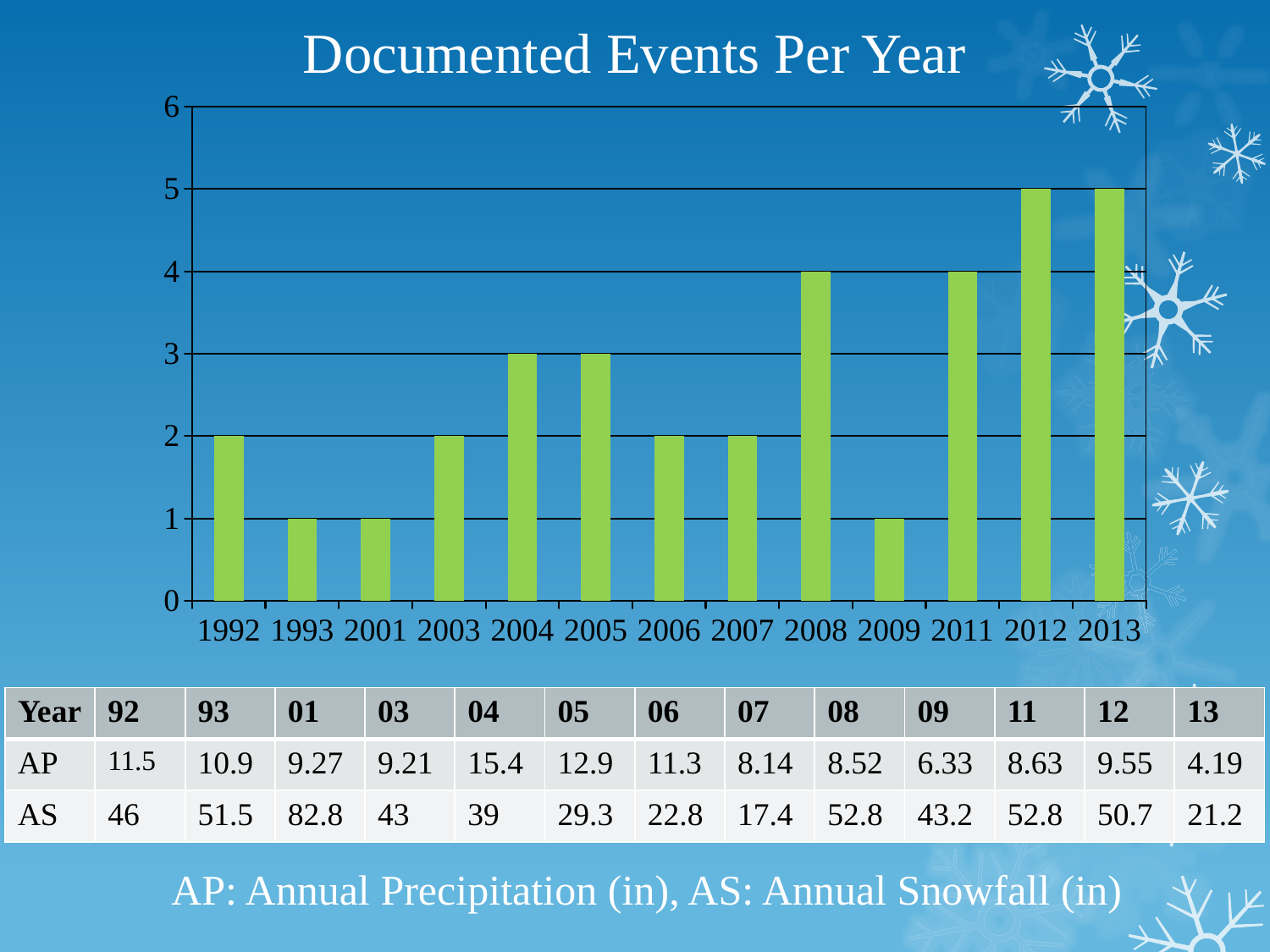
What is the title of the chart? Documented Events Per Year How many documented events are shown for 2005? 3 How many documented events are shown for 1992? 2 What type of chart is shown on the slide? bar chart How many documented events are shown for 2009? 1 How many documented events are shown for 2012? 5 Which year has more documented events, 2008 or 2005? 2008 What is the difference between the number of events in 2012 and in 1992? 3 How many years are shown on the x axis of the chart? 13 How many documented events are shown for 2008? 4 Which year has more documented events, 2011 or 2013? 2013 Is the value for 2004 greater or less than 2? greater